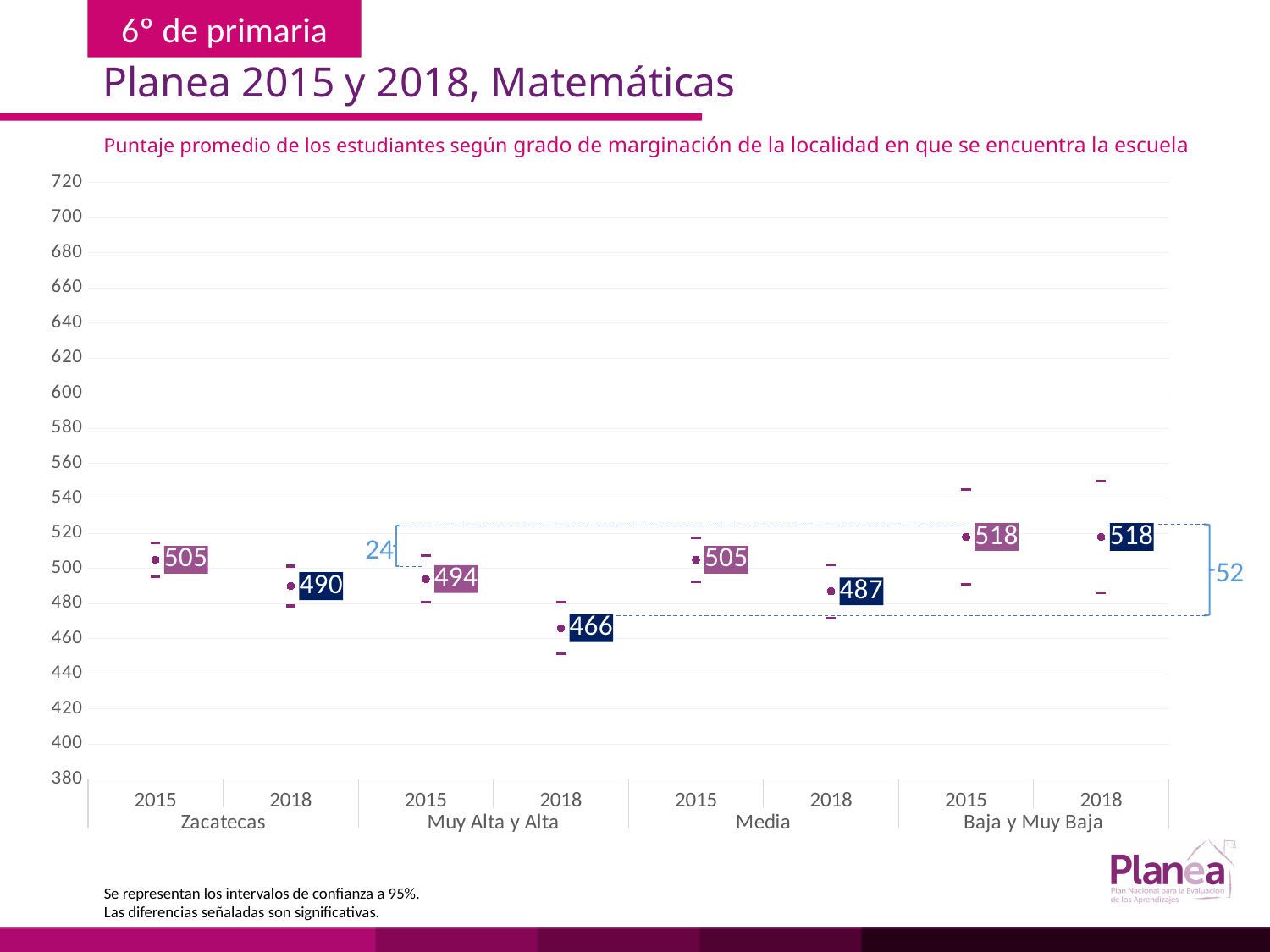
What is the difference between the Baja y Muy Baja 2018 score and the Muy Alta y Alta 2018 score, as annotated on the chart? 52 What is the 2018 average score for the Muy Alta y Alta marginación group? 466 Which is larger, the 2018 score for Media or the 2018 score for Muy Alta y Alta? Media What is the subtitle of the chart? Puntaje promedio de los estudiantes según grado de marginación de la localidad en que se encuentra la escuela Did the average score for Zacatecas rise or fall from 2015 to 2018? fall What is the 2015 average score for the Baja y Muy Baja group? 518 What is the difference between the Muy Alta y Alta 2015 score and its 2018 score? 28 What is the 2018 average score for the Media marginación group? 487 How many data points are plotted on the chart? 8 Which group and year has the lowest average score on the chart? Muy Alta y Alta, 2018 What is the 2015 average score for Zacatecas? 505 What is the difference between the Zacatecas 2015 score and the Zacatecas 2018 score? 15